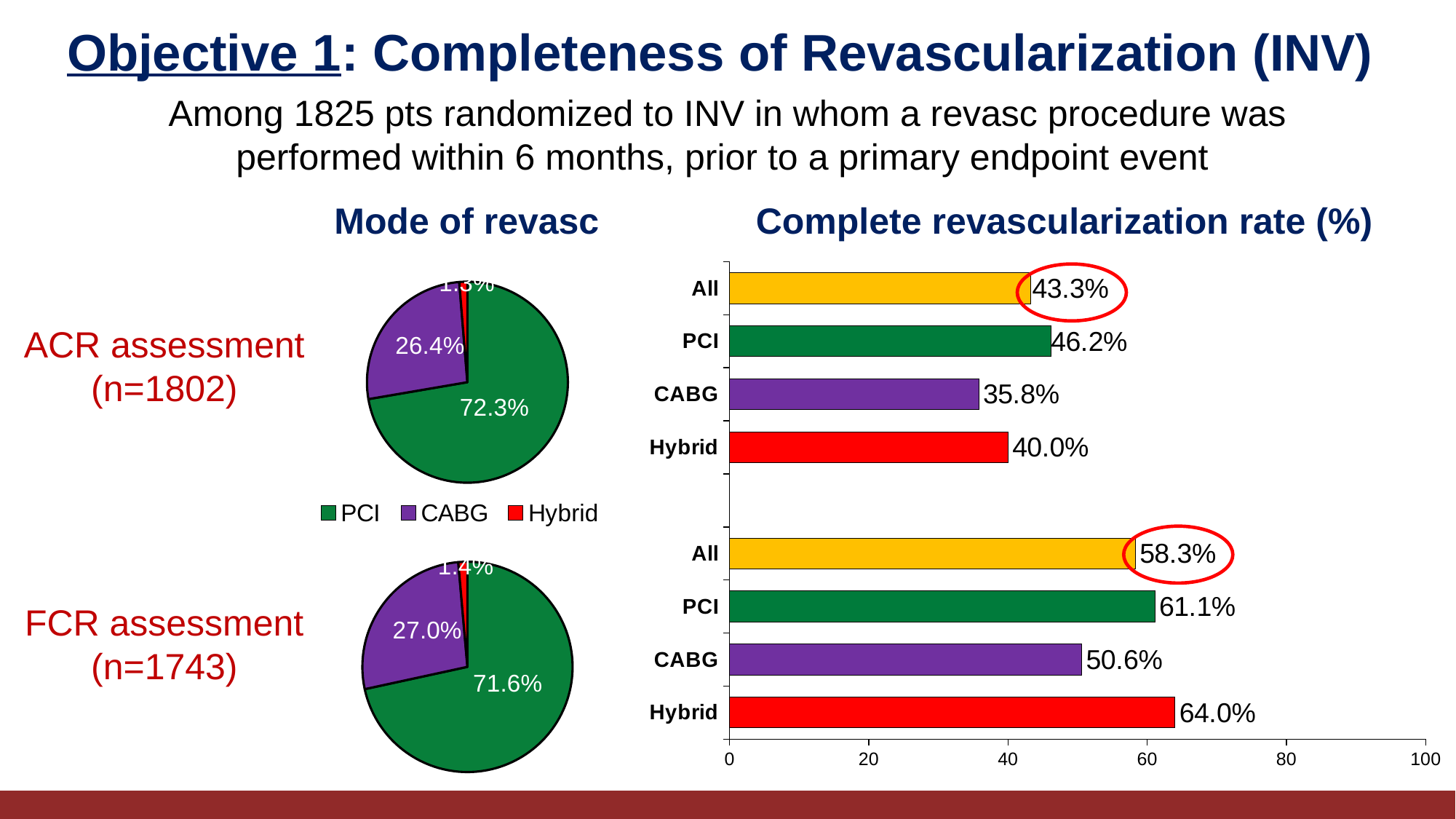
What kind of chart is used for the Complete revascularization rate (%)? Bar chart In the ACR assessment pie chart (Mode of revasc), what share of the pie is PCI? 72.3% In the FCR assessment pie chart (Mode of revasc), what share of the pie is Hybrid? 1.4% How many entries does the legend of the Mode of revasc pie charts list? 3 In the Complete revascularization rate bar chart, which category has the highest value under the FCR assessment? Hybrid In the FCR assessment pie chart (Mode of revasc), what share of the pie is CABG? 27.0% In the Complete revascularization rate bar chart, is the PCI value under the ACR assessment larger or smaller than the CABG value under the FCR assessment? smaller In the Complete revascularization rate bar chart, is the value for CABG under the ACR assessment greater or less than 40? less In the Complete revascularization rate bar chart, what is the value for All under the ACR assessment? 43.3% In the Complete revascularization rate bar chart, what is the difference between the All value for FCR assessment and the All value for ACR assessment? 15.0% In the Complete revascularization rate bar chart, what is the value for Hybrid under the FCR assessment? 64.0% In the Complete revascularization rate bar chart, which category has the lowest value under the ACR assessment? CABG